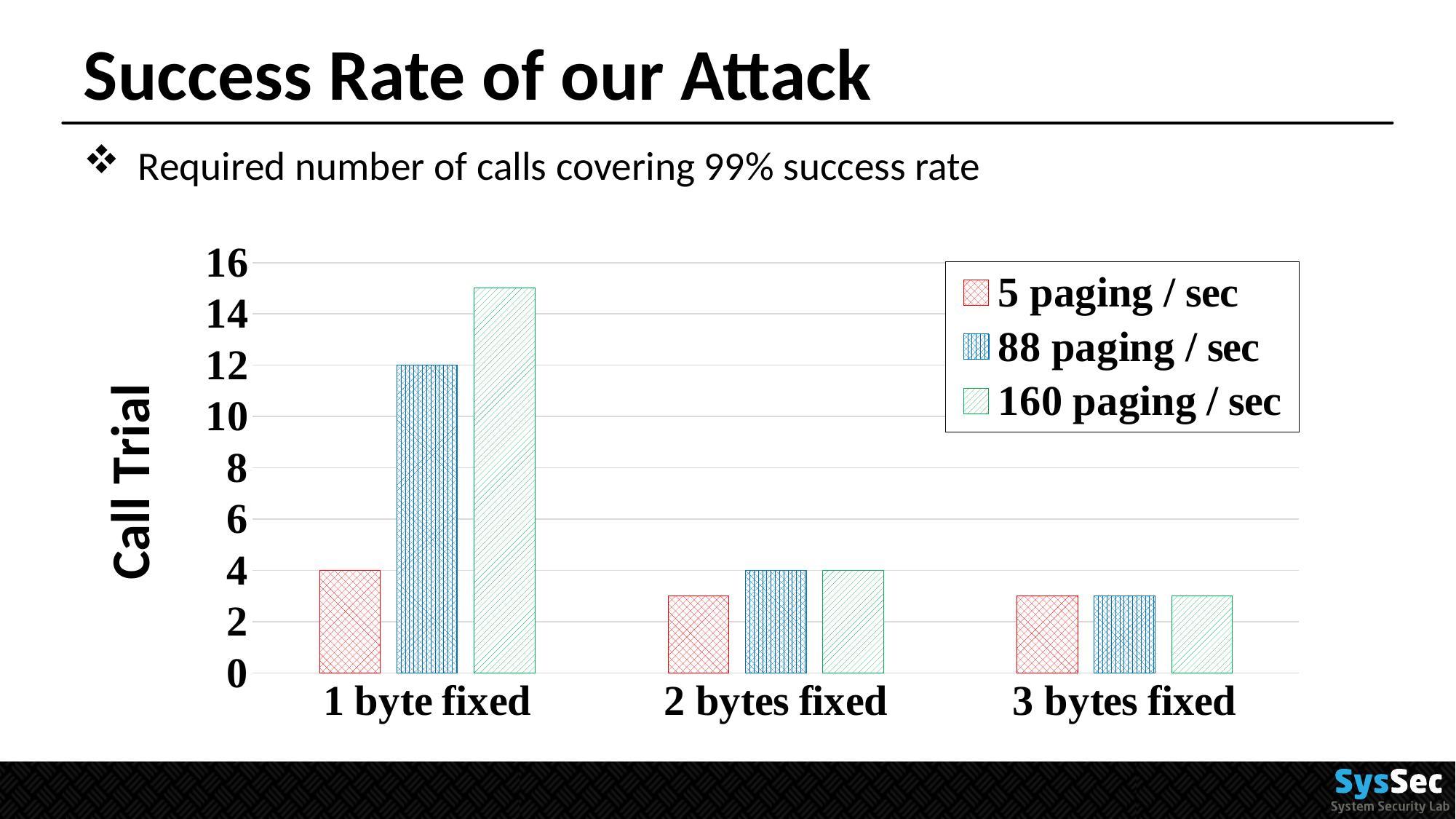
What is the Call Trial value for 5 paging / sec at 1 byte fixed? 4 What is the Call Trial value for 88 paging / sec at 1 byte fixed? 12 What kind of chart is shown on the slide? bar chart Which series has the highest value at 1 byte fixed? 160 paging / sec What is the label of the y axis? Call Trial How many categories are shown on the x axis? 3 Is the value for 5 paging / sec at 3 bytes fixed greater or less than 4? less Which series has the lowest value at 1 byte fixed? 5 paging / sec What is the Call Trial value for 160 paging / sec at 2 bytes fixed? 4 What is the difference between the 88 paging / sec and 5 paging / sec values at 1 byte fixed? 8 Is the value for 160 paging / sec at 1 byte fixed greater or less than 14? greater How many series does the legend list? 3